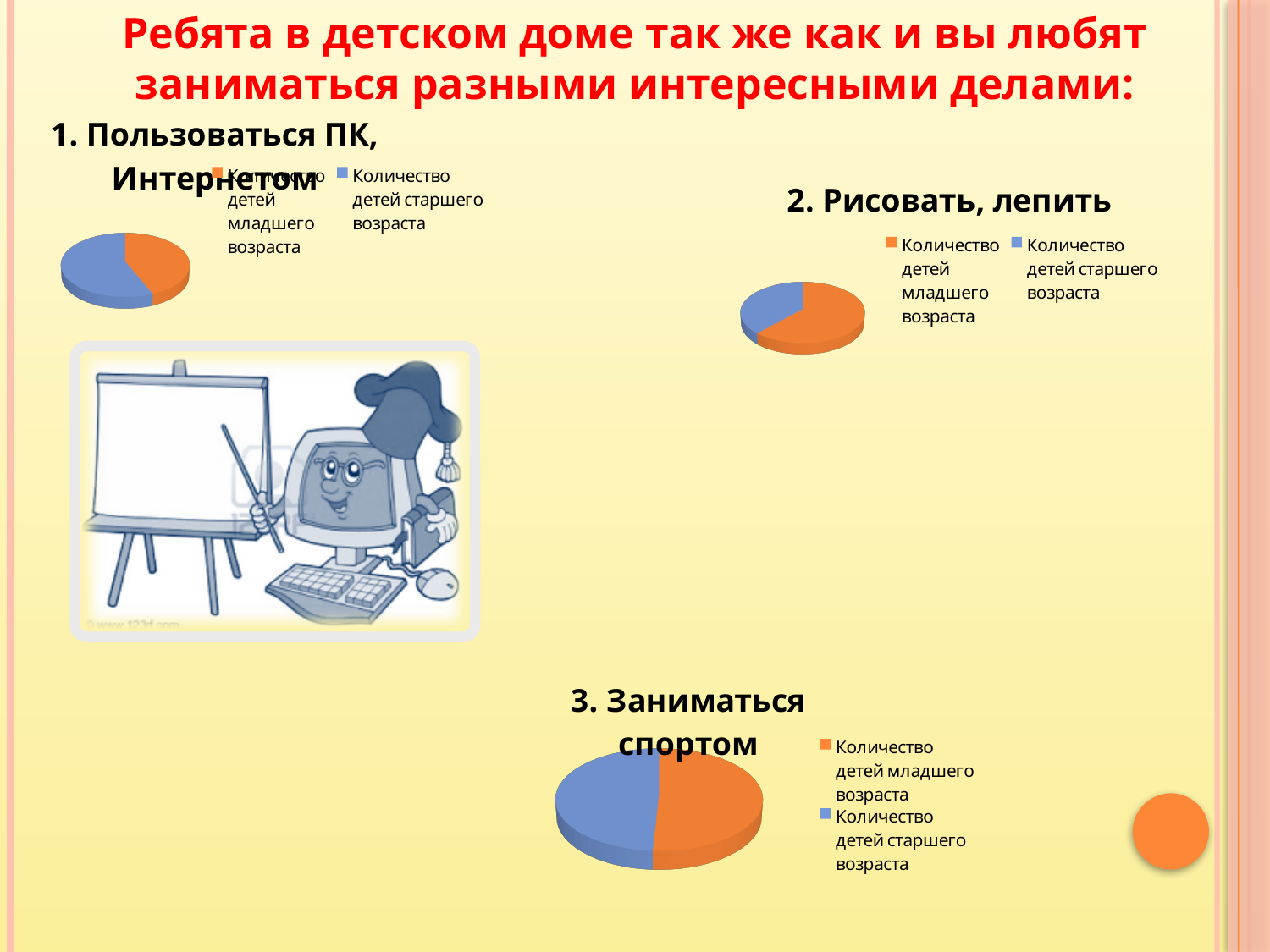
In the chart under "1. Пользоваться ПК, Интернетом", how many entries does the legend list? 2 In the chart under "2. Рисовать, лепить", what colour represents "Количество детей старшего возраста"? blue What kind of chart is used under "3. Заниматься спортом"? pie chart How many charts are on the slide? 3 What kind of chart is used under "1. Пользоваться ПК, Интернетом"? pie chart In the chart under "1. Пользоваться ПК, Интернетом", which slice is larger: "Количество детей младшего возраста" or "Количество детей старшего возраста"? Количество детей старшего возраста In the chart under "3. Заниматься спортом", how many entries does the legend list? 2 In the chart under "1. Пользоваться ПК, Интернетом", which category has the smallest slice? Количество детей младшего возраста In the chart under "2. Рисовать, лепить", which slice is larger: "Количество детей младшего возраста" or "Количество детей старшего возраста"? Количество детей младшего возраста In the chart under "3. Заниматься спортом", what colour represents "Количество детей младшего возраста"? orange In the chart under "2. Рисовать, лепить", how many slices does the pie have? 2 In the chart under "2. Рисовать, лепить", which category has the largest slice? Количество детей младшего возраста